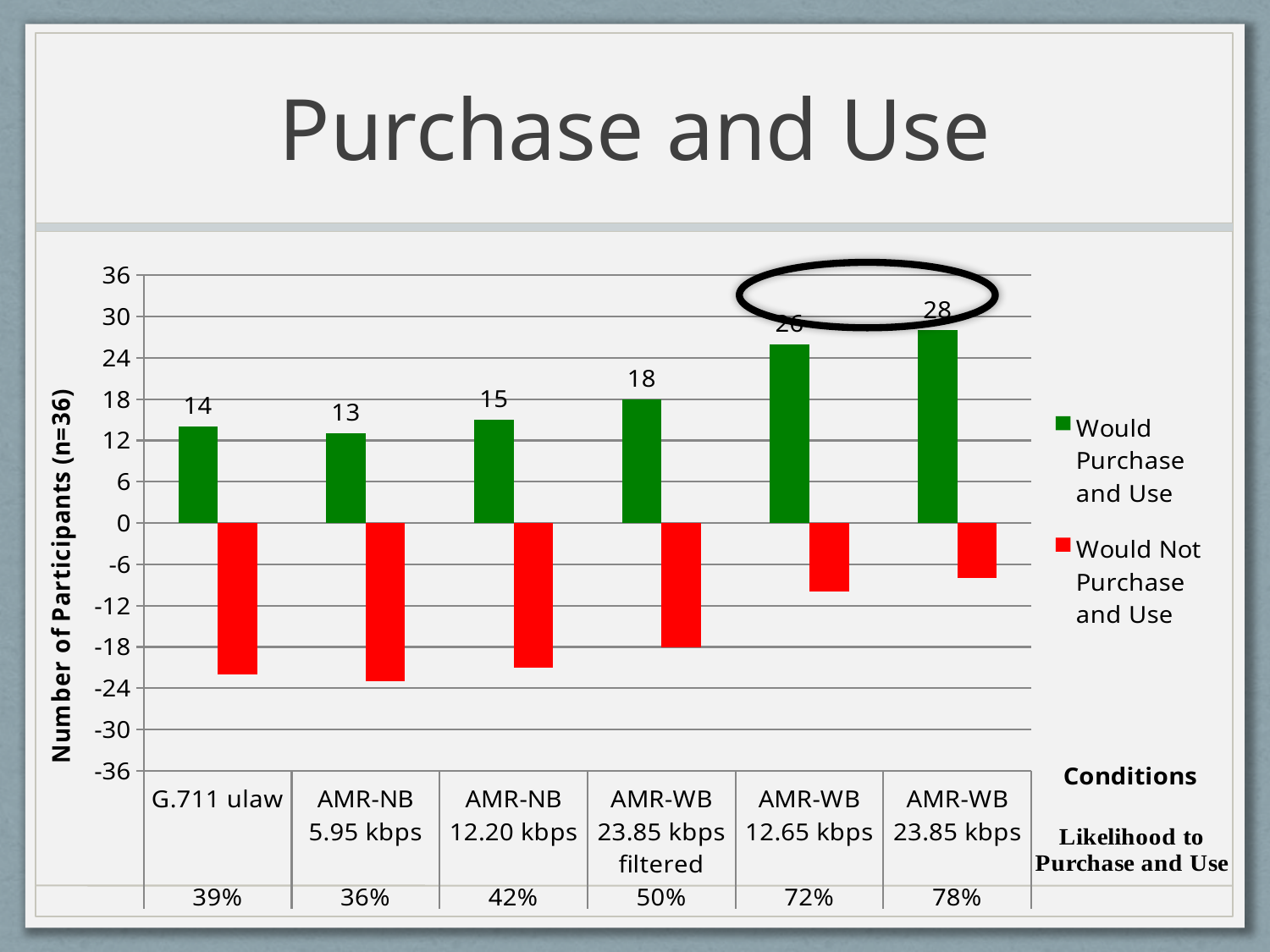
How many participants would purchase and use AMR-WB 23.85 kbps filtered? 18 Which condition has the highest number of participants who would purchase and use? AMR-WB 23.85 kbps What type of chart is shown on the slide? bar chart Is the 'Would Not Purchase and Use' value for AMR-NB 5.95 kbps greater or less than -18? less Which condition has the lowest number of participants who would purchase and use? AMR-NB 5.95 kbps What is the difference between the 'Would Purchase and Use' values for AMR-WB 23.85 kbps and G.711 ulaw? 14 How many series does the legend list? 2 How many participants would purchase and use AMR-WB 23.85 kbps? 28 How many conditions are shown on the x axis? 6 How many participants would purchase and use G.711 ulaw? 14 What is the Likelihood to Purchase and Use percentage shown for AMR-WB 12.65 kbps? 72% Which has more participants who would purchase and use: AMR-NB 12.20 kbps or AMR-WB 12.65 kbps? AMR-WB 12.65 kbps